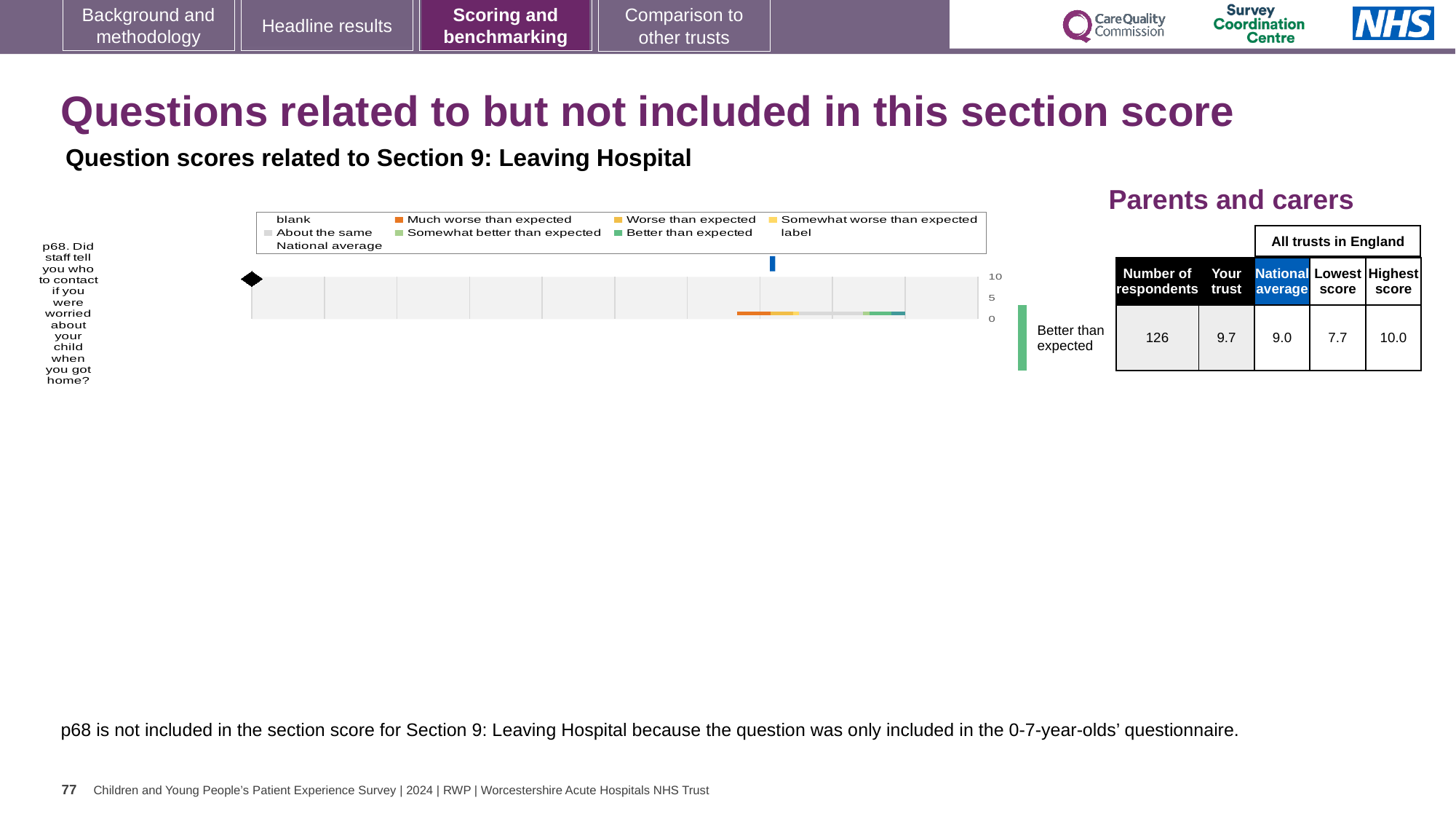
Which is higher for p68: the 'Your trust' score or the National average? Your trust In the table next to the chart, how many respondents answered p68? 126 Which question number is plotted in the chart? p68 In the table next to the chart, what is the 'Your trust' score for p68? 9.7 How many entries does the chart legend list? 9 What benchmark category label is shown to the right of the p68 bar? Better than expected What kind of chart is used to show the benchmarking for question p68? bar chart What is the difference between the 'Your trust' score and the National average for p68? 0.7 In the table next to the chart, what is the National average score for p68? 9.0 In the table next to the chart, what is the Lowest score among all trusts in England for p68? 7.7 In the table next to the chart, what is the Highest score among all trusts in England for p68? 10.0 How many questions are plotted in the chart? 1